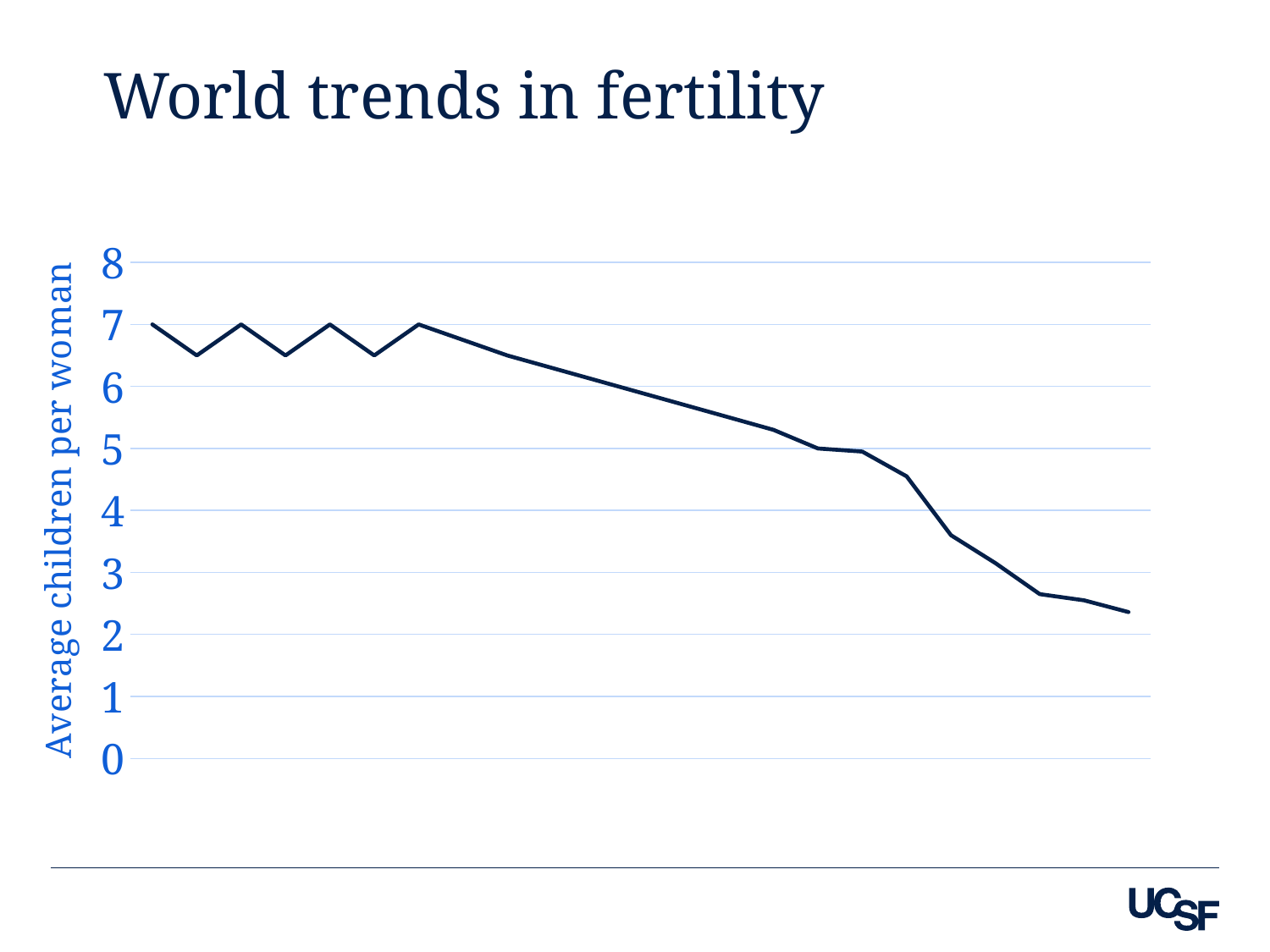
What is the maximum value shown on the vertical axis? 8 What value does the line start at on the far left of the chart? 7 Is the value at the far right end of the line greater or less than 2? greater Is the value at the far right end of the line greater or less than 3? less What kind of chart is shown on the slide? line chart What is the title of the chart? World trends in fertility How many lines (series) are plotted on the chart? 1 What is the label on the vertical axis of the chart? Average children per woman Is the lowest value on the line greater or less than 1? greater Which is larger, the value at the left end of the line or the value at the right end? the left end What is the highest value reached by the line? 7 Overall, do the values rise or fall from left to right along the x axis? fall